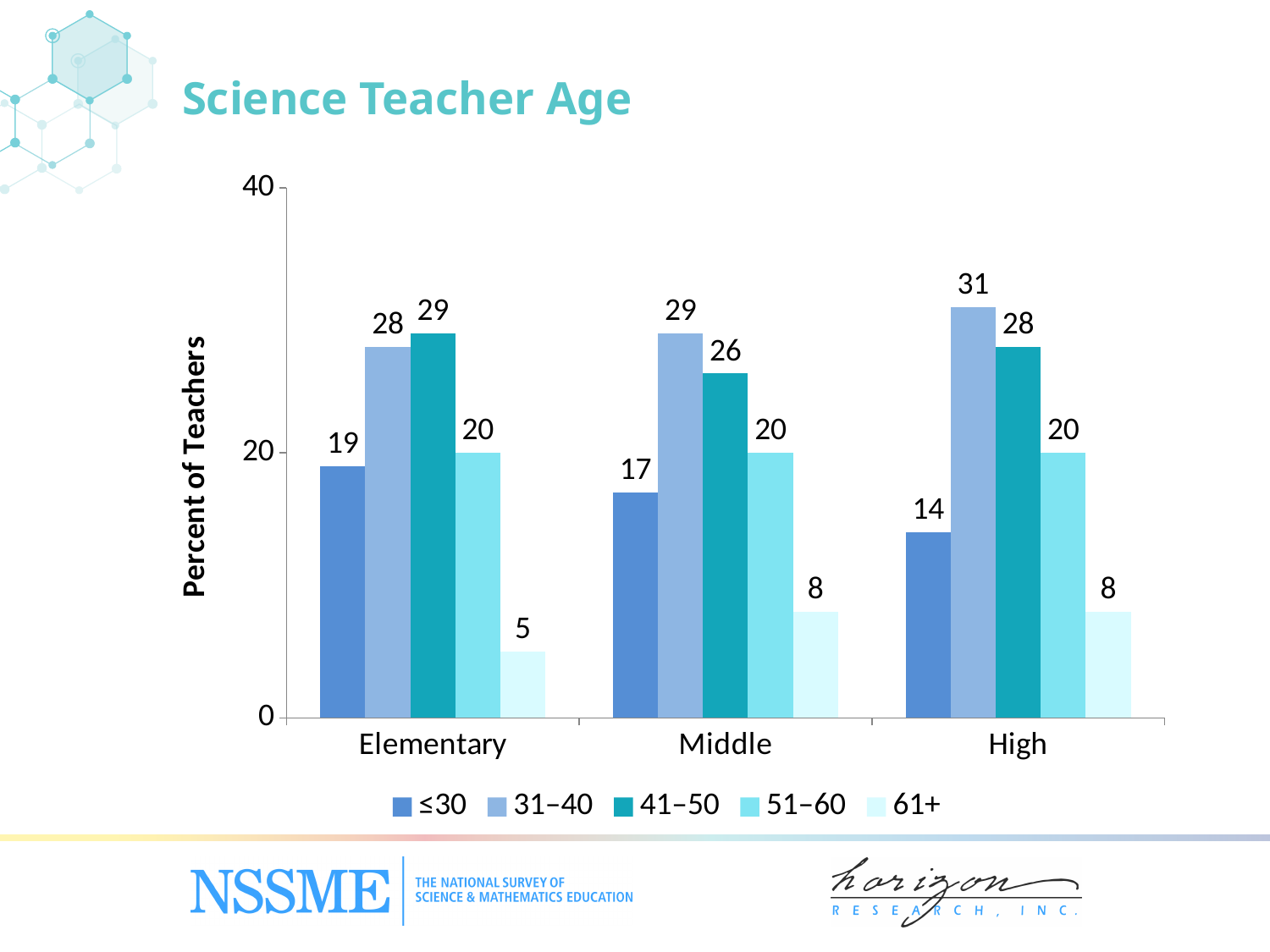
What percent of elementary science teachers are aged 31–40? 28 Which age group has the lowest percent of elementary science teachers? 61+ What kind of chart is shown on the slide? bar chart What is the label of the y axis? Percent of Teachers What percent of middle school science teachers are aged 41–50? 26 Which age group has the highest percent of high school science teachers? 31–40 What is the difference between the percent of elementary and high school science teachers aged ≤30? 5 How many age groups does the legend list? 5 Is the value for elementary teachers aged 41–50 greater or less than 20? greater Which is larger: the percent of middle school science teachers aged 31–40 or aged 41–50? 31–40 What percent of high school science teachers are aged 61+? 8 How many school levels are shown on the x axis? 3